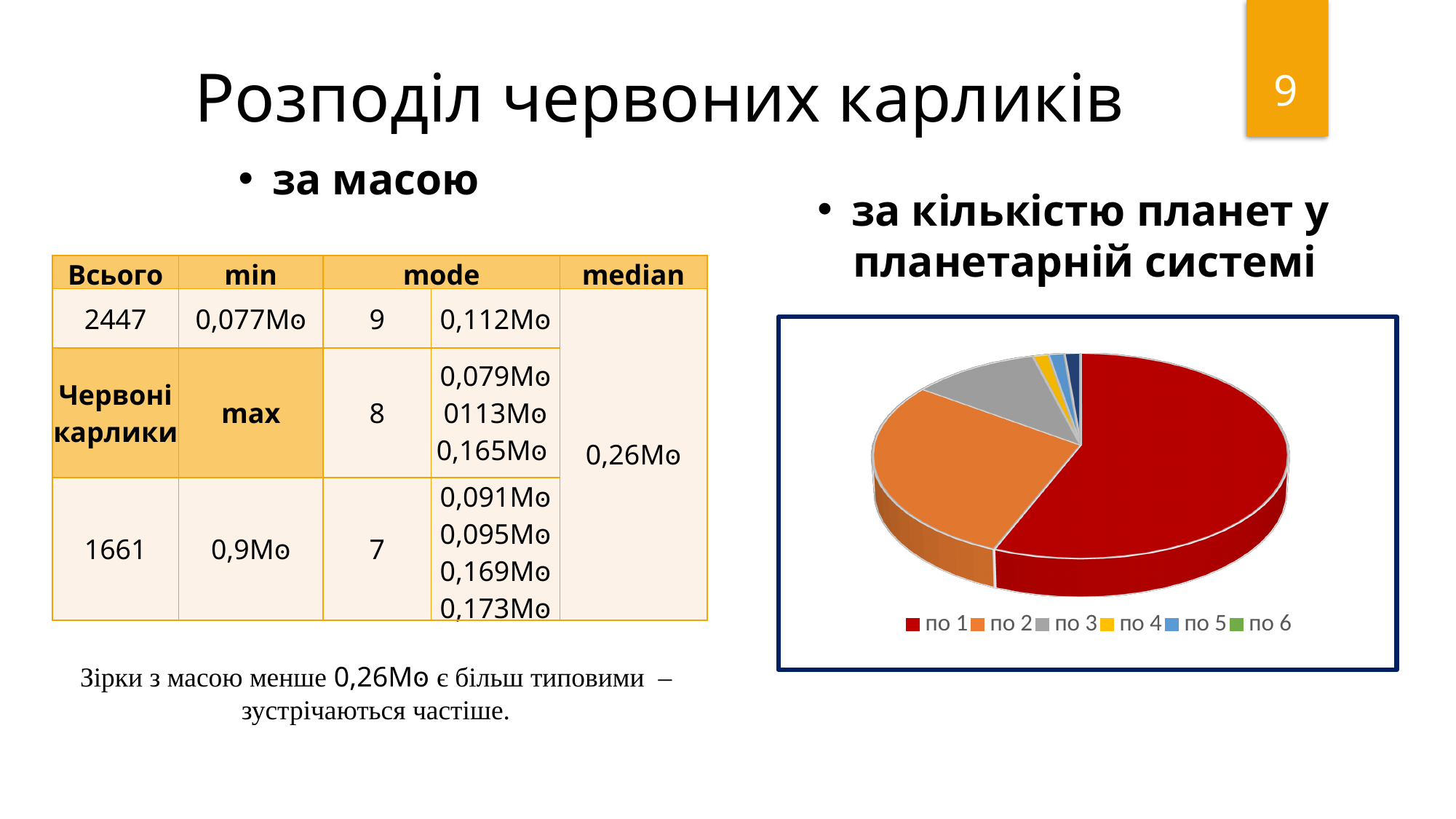
What colour is the slice for по 1 in the pie chart? red How many categories are shown in the legend of the pie chart? 6 What kind of chart is shown on the right side of the slide? pie chart In the pie chart, which slice is larger: по 1 or по 3? по 1 How many entries does the legend of the pie chart list? 6 What heading is given above the pie chart? за кількістю планет у планетарній системі In the pie chart, which slice is larger: по 3 or по 4? по 3 In the pie chart, which slice is larger: по 1 or по 2? по 1 Which category has the largest slice in the pie chart? по 1